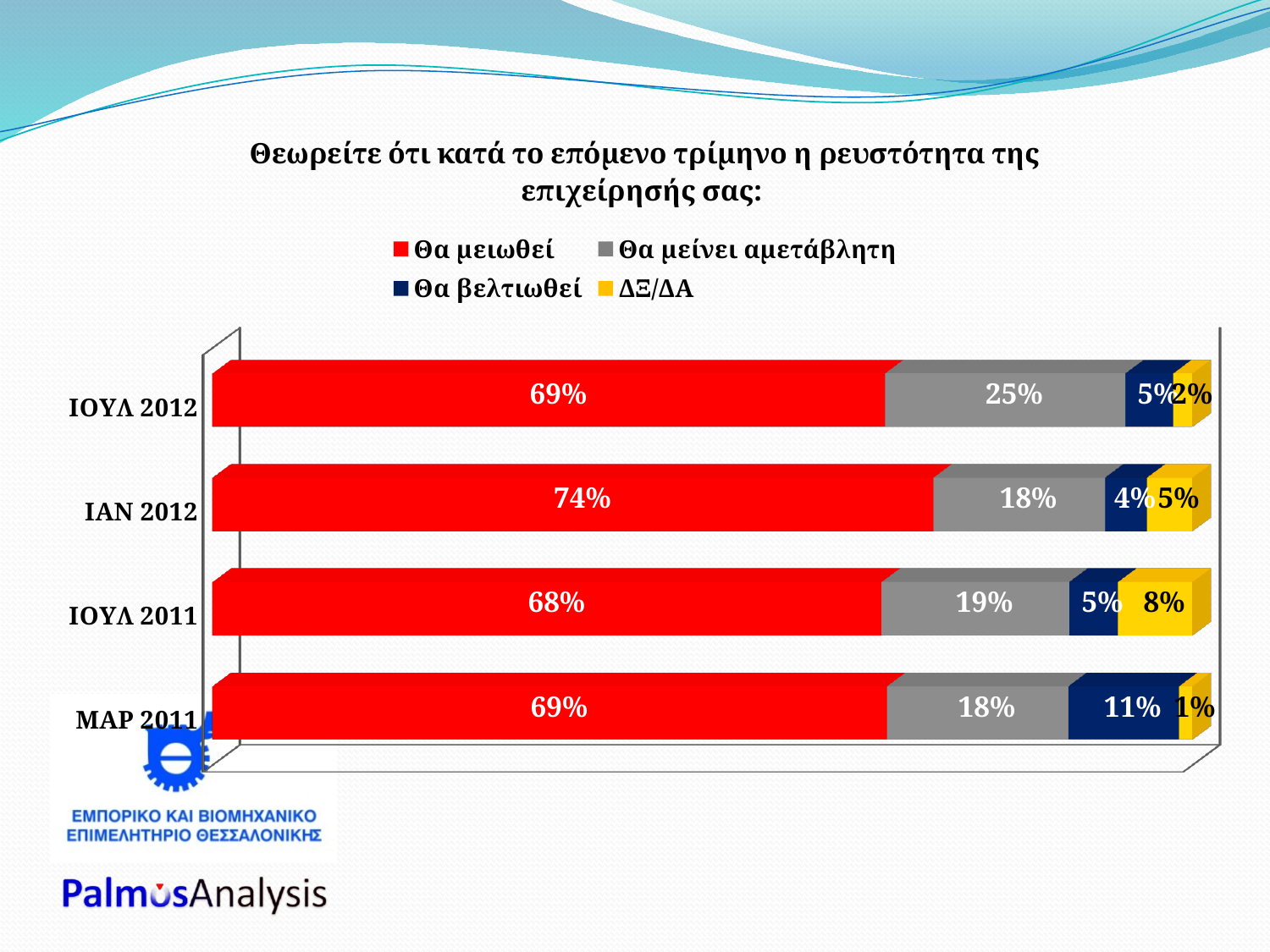
What is the value for 'Θα βελτιωθεί' in ΜΑΡ 2011? 11% How many series does the legend list? 4 How many time periods (categories) are shown on the chart? 4 Which colour represents the 'ΔΞ/ΔΑ' series in the chart? yellow In which period was the 'Θα μειωθεί' share the highest? ΙΑΝ 2012 What is the difference between the 'Θα μειωθεί' values for ΙΑΝ 2012 and ΙΟΥΛ 2011? 6% What is the value for 'ΔΞ/ΔΑ' in ΙΟΥΛ 2011? 8% What is the value for 'Θα μείνει αμετάβλητη' in ΙΟΥΛ 2012? 25% What type of chart is shown on the slide? stacked bar chart What percentage of respondents in ΙΑΝ 2012 answered 'Θα μειωθεί'? 74% Which is larger: the 'Θα μείνει αμετάβλητη' value in ΙΟΥΛ 2012 or in ΙΟΥΛ 2011? ΙΟΥΛ 2012 In which period was the 'Θα βελτιωθεί' share the lowest? ΙΑΝ 2012